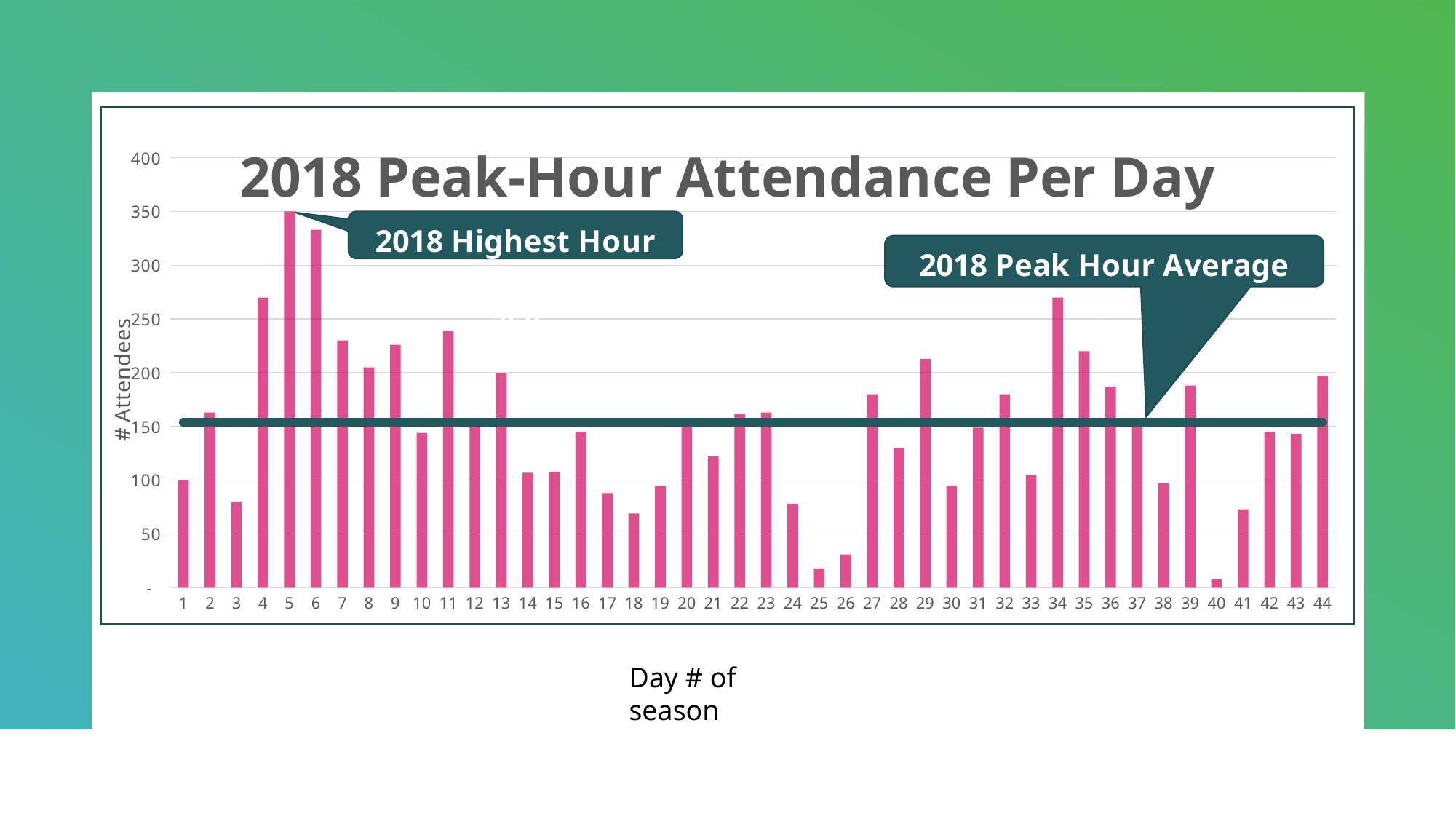
What is the title of the chart? 2018 Peak-Hour Attendance Per Day Is the value for day 6 greater or less than 300? greater Is the value for day 34 greater or less than 250? greater What does the horizontal line across the chart represent, according to the callout? 2018 Peak Hour Average Is the value for day 18 greater or less than 100? less Which day of the season has the highest peak-hour attendance? 5 What kind of chart is shown on the slide? bar chart Which has the higher peak-hour attendance, day 5 or day 34? day 5 Which has the higher peak-hour attendance, day 3 or day 4? day 4 How many days of the season are plotted on the x axis? 44 Which day of the season has the lowest peak-hour attendance? 40